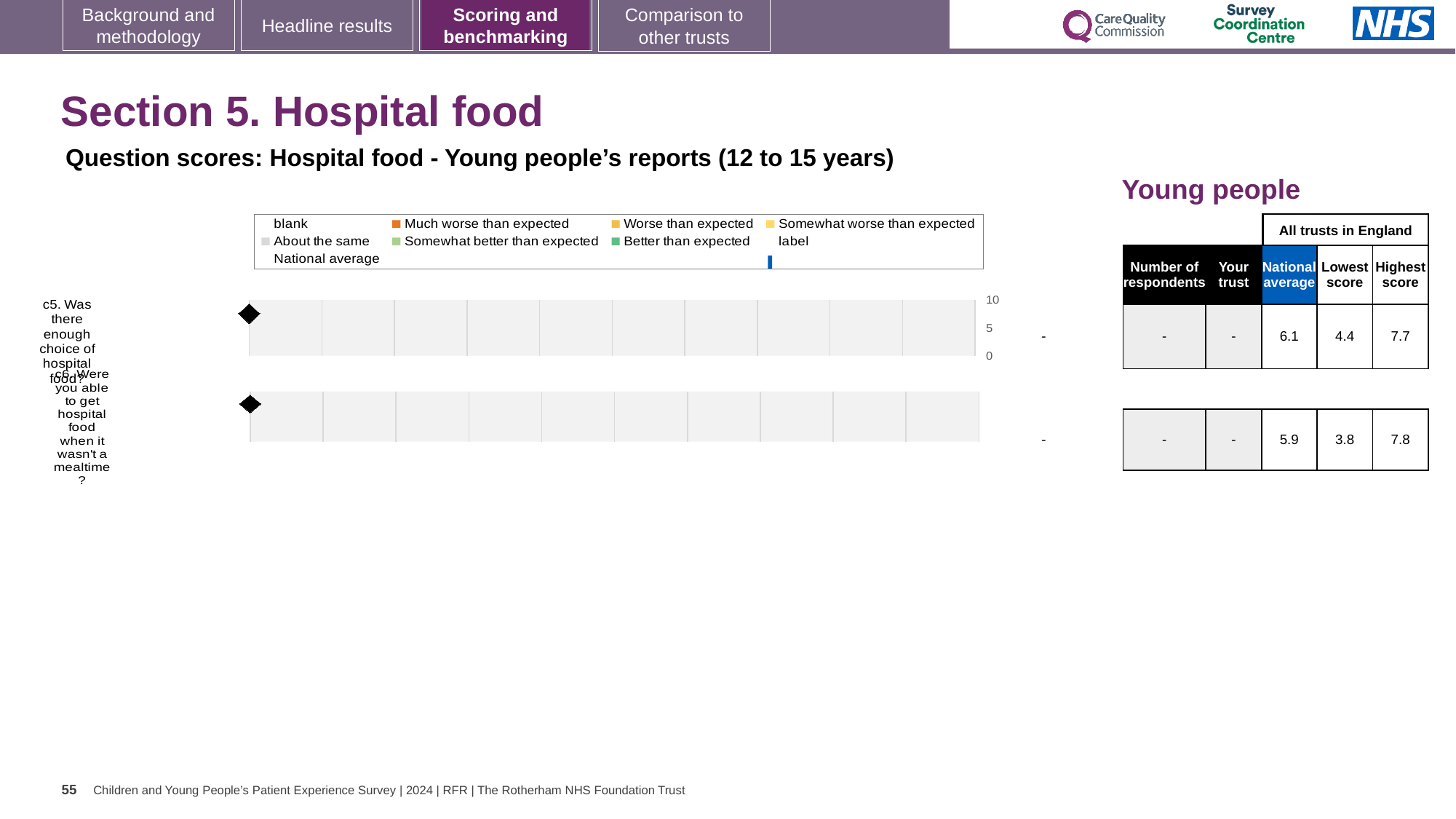
What is the lowest score across all trusts in England for c6 (Were you able to get hospital food when it wasn't a mealtime?)? 3.8 What is the difference between the national average scores for c5 and c6? 0.2 What is the highest score across all trusts in England for c5? 7.7 What kind of chart is shown on the slide? bar chart What is the difference between the highest and lowest trust scores for c5? 3.3 What is the subtitle describing the chart's question scores? Question scores: Hospital food - Young people's reports (12 to 15 years) Which question has the higher national average score, c5 or c6? c5 How many survey questions are plotted on the chart? 2 What value is shown for 'Your trust' for c5? - What is the highest score across all trusts in England for c6? 7.8 What is the highest tick value shown on the chart's score axis? 10 What is the national average score for c5 (Was there enough choice of hospital food?)? 6.1